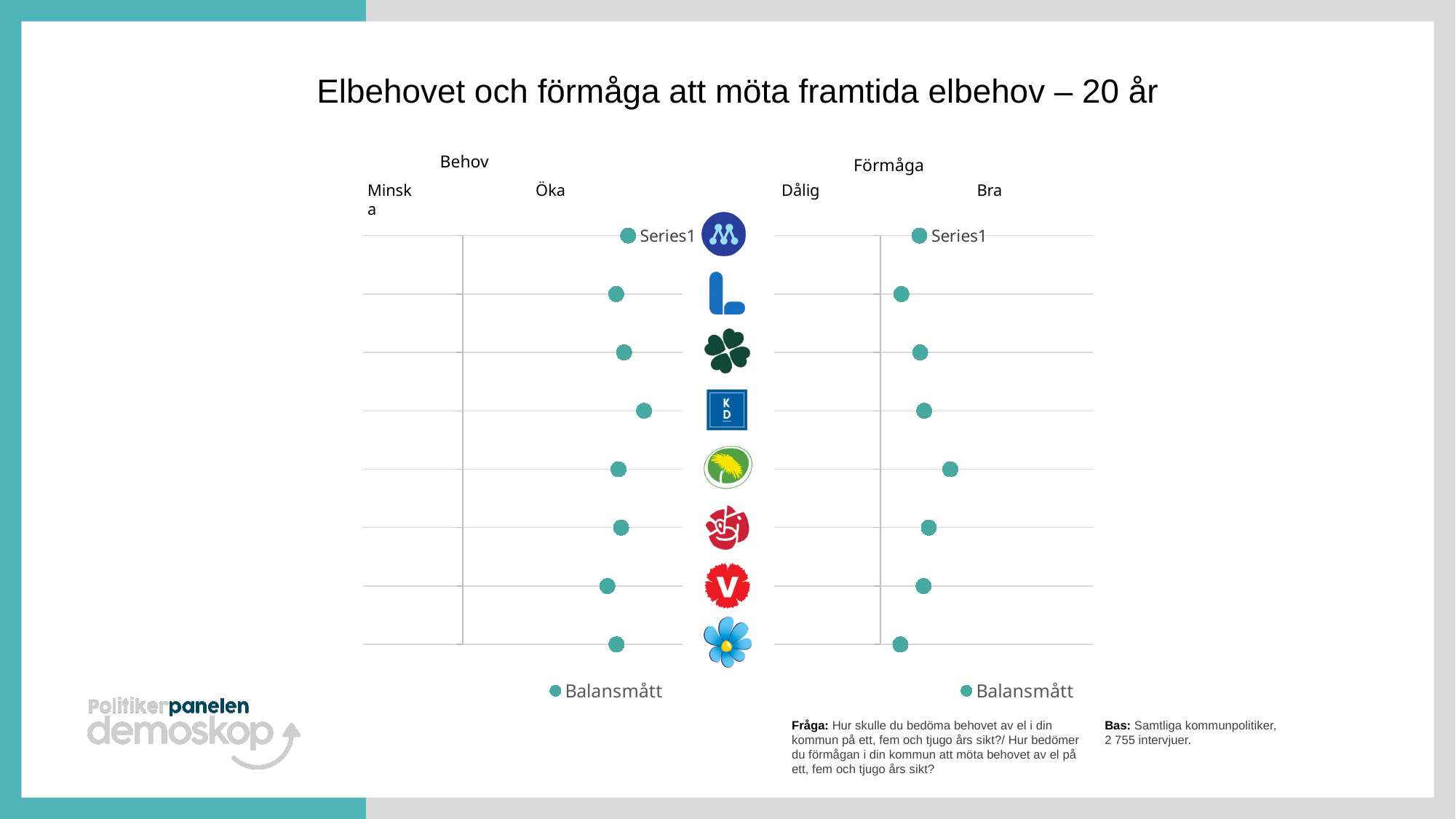
How many data points are plotted in the Förmåga chart? 8 How many series does the legend of the Förmåga chart list? 1 How many data points are plotted in the Behov chart? 8 What is the title of the slide? Elbehovet och förmåga att möta framtida elbehov – 20 år In the Behov chart, which point lies furthest to the right (towards Öka): the top point or the bottom point? the top point In the Förmåga chart, which point lies furthest to the right (towards Bra): the top point or the fifth point from the top? the fifth point from the top How many series does the legend of the Behov chart list? 1 What kind of chart is the Förmåga chart on the right? dot (scatter) chart In the Behov chart, are the plotted points on the Minska side or the Öka side of the vertical axis line? Öka side What is the legend entry shown below each chart? Balansmått What kind of chart is the Behov chart on the left? dot (scatter) chart